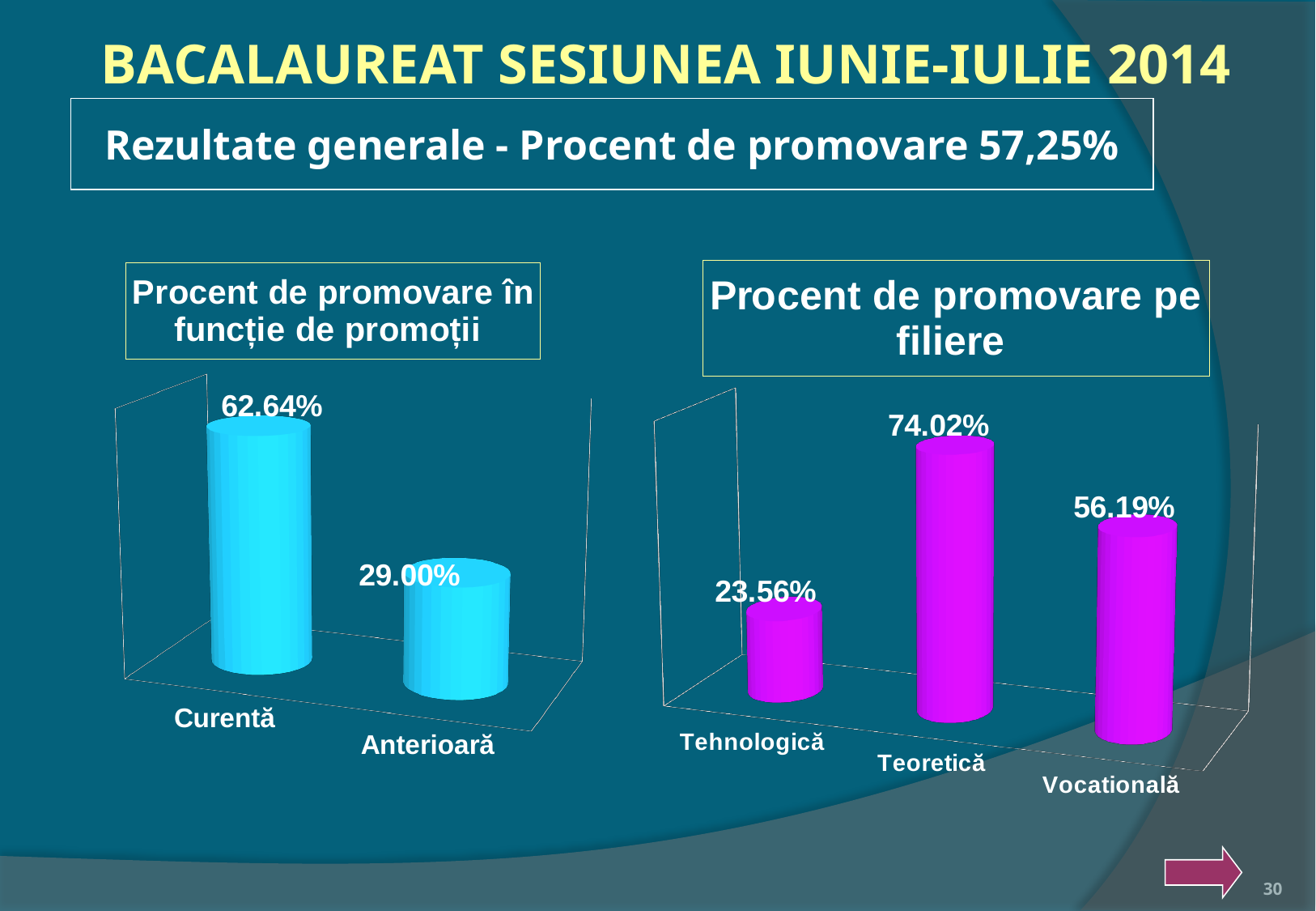
In the chart 'Procent de promovare pe filiere', what is the value for Teoretică? 74.02% In the chart 'Procent de promovare în funcție de promoții', how many categories are shown? 2 In the chart 'Procent de promovare pe filiere', what is the difference between Teoretică and Vocațională? 17.83% In the chart 'Procent de promovare în funcție de promoții', what is the value for Anterioară? 29.00% In the chart 'Procent de promovare pe filiere', which category has the highest value? Teoretică In the chart 'Procent de promovare pe filiere', what is the value for Tehnologică? 23.56% In the chart 'Procent de promovare pe filiere', which category has the lowest value? Tehnologică In the chart 'Procent de promovare pe filiere', what is the value for Vocațională? 56.19% In the chart 'Procent de promovare pe filiere', how many categories are shown? 3 In the chart 'Procent de promovare în funcție de promoții', what is the value for Curentă? 62.64% In the chart 'Procent de promovare în funcție de promoții', what is the difference between Curentă and Anterioară? 33.64% What kind of chart is the chart 'Procent de promovare pe filiere'? Bar chart